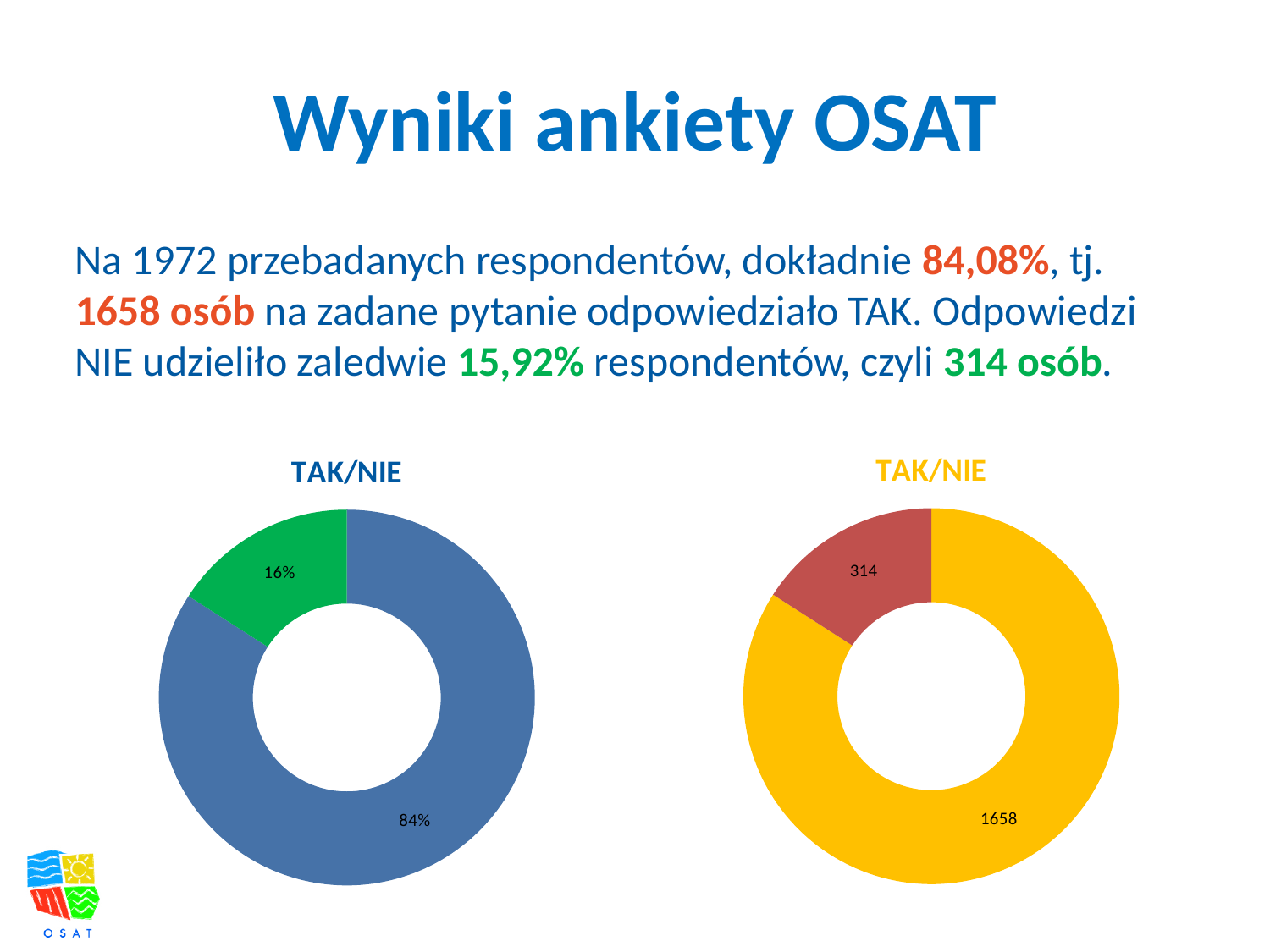
On the right chart, what value is shown on the red slice? 314 On the right chart, what is the difference between the yellow slice value and the red slice value? 1344 On the left chart, which slice has the smallest share? the green slice (16%) On the right chart, which is larger: the yellow slice or the red slice? the yellow slice On the left chart, what value is shown on the green slice? 16% What is the title of the right chart? TAK/NIE On the right chart, which slice has the largest value? the yellow slice (1658) What kind of chart is the left chart on the slide? doughnut chart On the right chart, what is the total of the two slice values? 1972 On the left chart, what value is shown on the blue slice? 84% How many slices does the left chart have? 2 On the right chart, what value is shown on the yellow slice? 1658